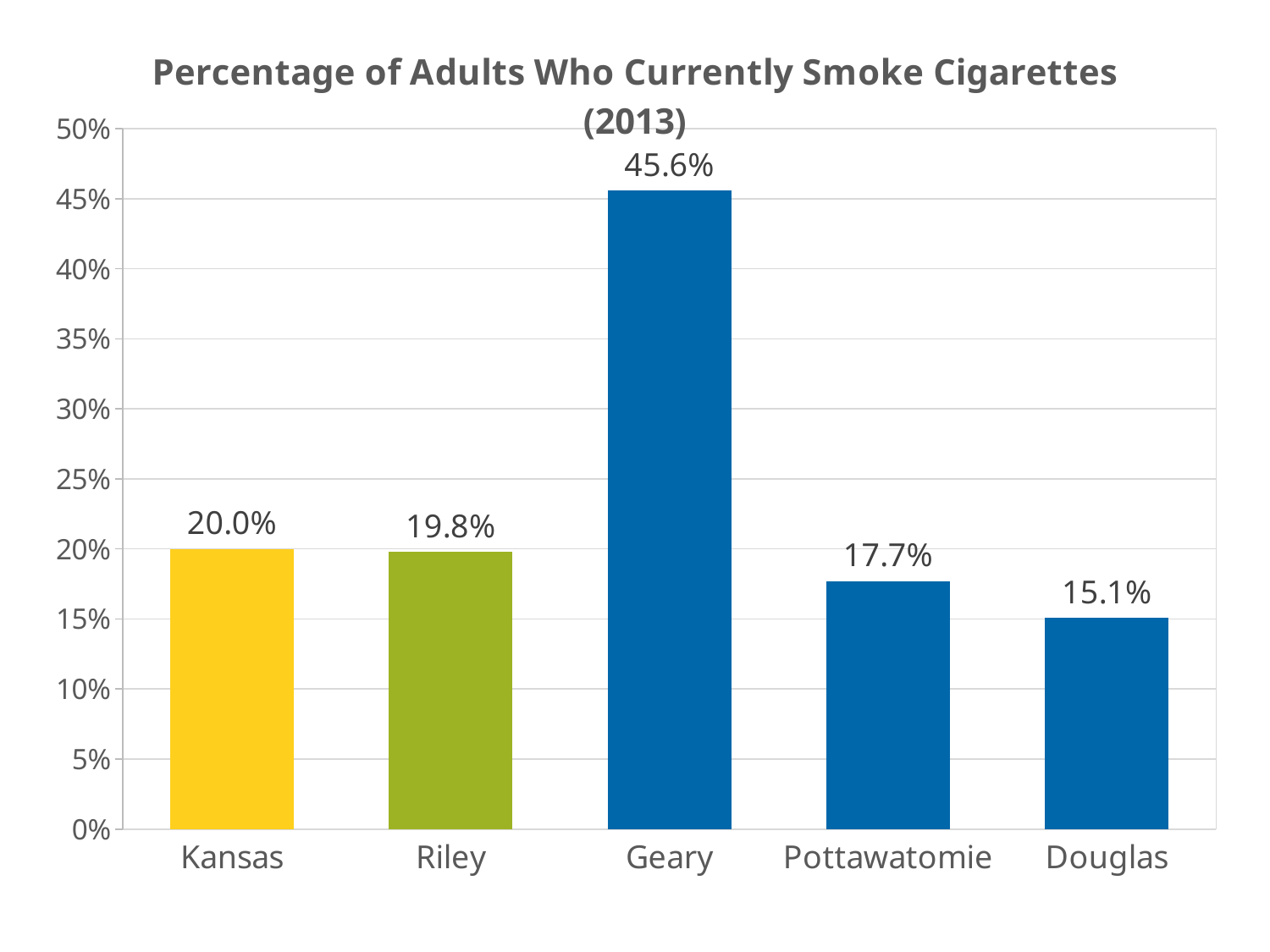
Is the value for Geary greater or less than 40%? greater What is the value shown for Douglas? 15.1% How many categories are shown on the x axis? 5 Which category has the lowest percentage of adults who currently smoke? Douglas Which category has the highest percentage of adults who currently smoke? Geary Which has a higher value, Pottawatomie or Douglas? Pottawatomie What is the difference between the values for Geary and Kansas? 25.6% What is the value shown for Pottawatomie? 17.7% What is the percentage of adults who currently smoke cigarettes in Geary? 45.6% What kind of chart is shown on the slide? Bar chart What is the difference between the values for Riley and Douglas? 4.7% What is the value shown for Kansas? 20.0%